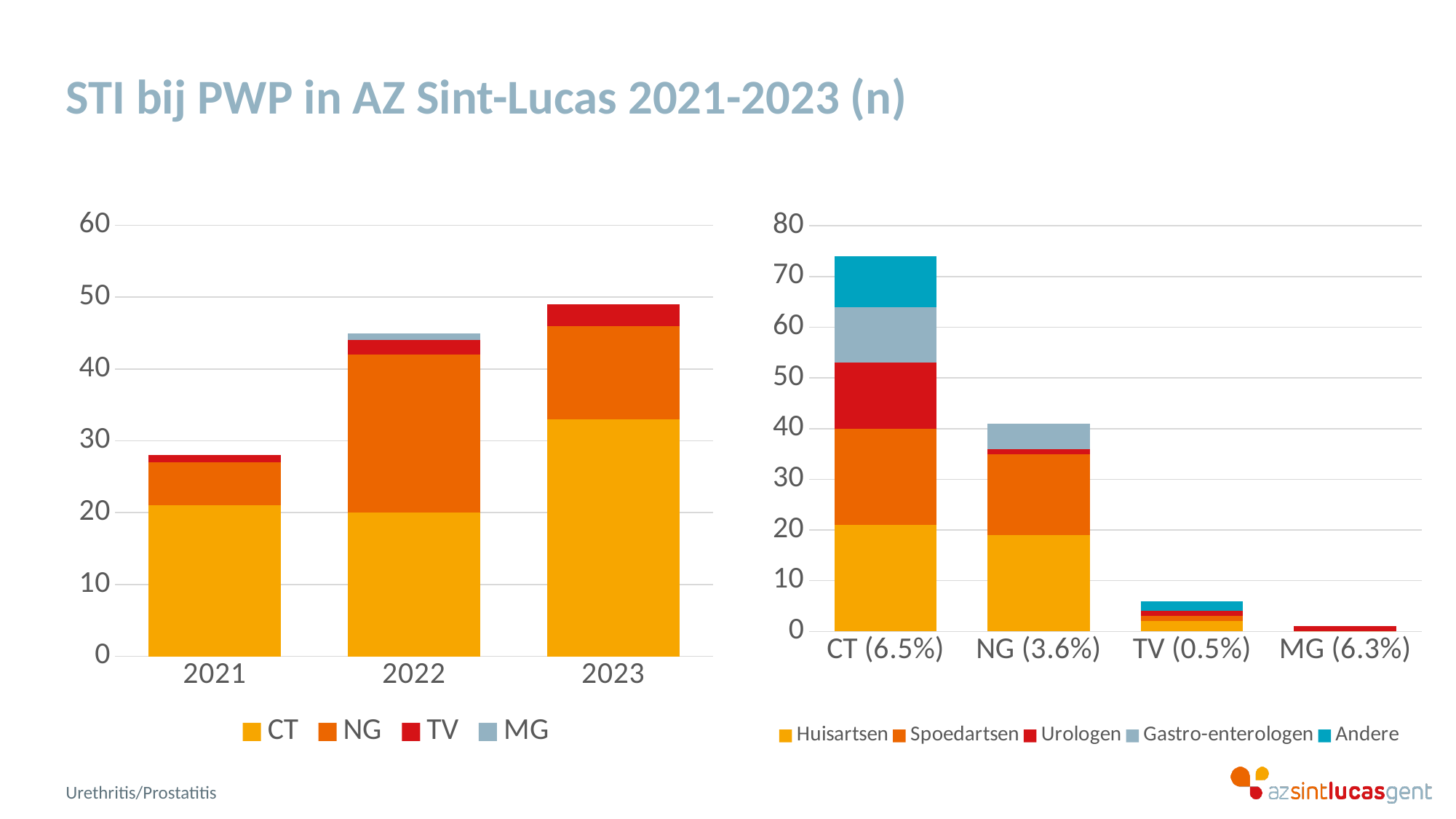
In the right chart, is the total for CT (6.5%) greater or less than 70? greater What kind of chart is the left chart (by year 2021-2023)? stacked bar chart In the right chart, which category has the highest total bar? CT (6.5%) How many series does the legend of the left chart (by year) list? 4 In the right chart, is the total for TV (0.5%) greater or less than 10? less In the left chart, do the total bar heights rise or fall from 2021 to 2023? rise How many series does the legend of the right chart (by pathogen) list? 5 How many categories are shown on the x axis of the right chart? 4 In the left chart, which year has the highest total bar? 2023 How many years are shown on the x axis of the left chart? 3 In the left chart, is the total for 2021 greater or less than 30? less In the right chart, which category has the lowest total bar? MG (6.3%)